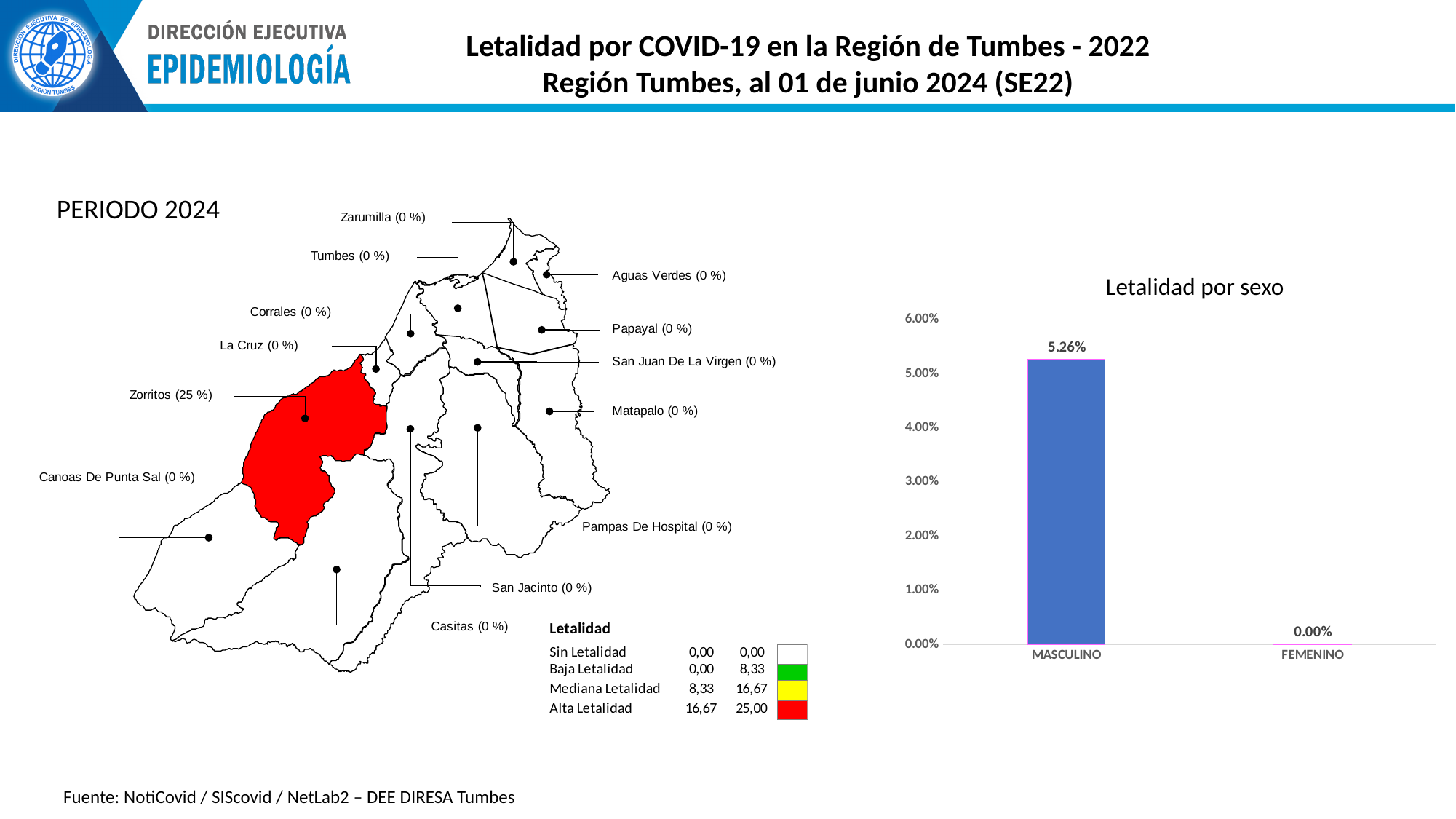
On the map on the left, what lethality value is shown for Tumbes? 0 % In the 'Letalidad por sexo' chart, how many categories are shown on the x axis? 2 In the 'Letalidad por sexo' chart, is the value for MASCULINO greater or less than 5.00%? greater In the 'Letalidad por sexo' chart, which category has the highest value? MASCULINO In the 'Letalidad por sexo' chart, what is the value for MASCULINO? 5.26% In the 'Letalidad' legend on the map, what is the upper limit for 'Alta Letalidad'? 25,00 What kind of chart is 'Letalidad por sexo'? bar chart In the 'Letalidad por sexo' chart, which category has the lowest value? FEMENINO On the map on the left, which district is shown with a lethality of 25 %? Zorritos In the 'Letalidad por sexo' chart, what is the value for FEMENINO? 0.00% In the 'Letalidad por sexo' chart, what is the highest value shown on the y axis? 6.00% In the 'Letalidad por sexo' chart, what is the difference between the MASCULINO and FEMENINO values? 5.26%